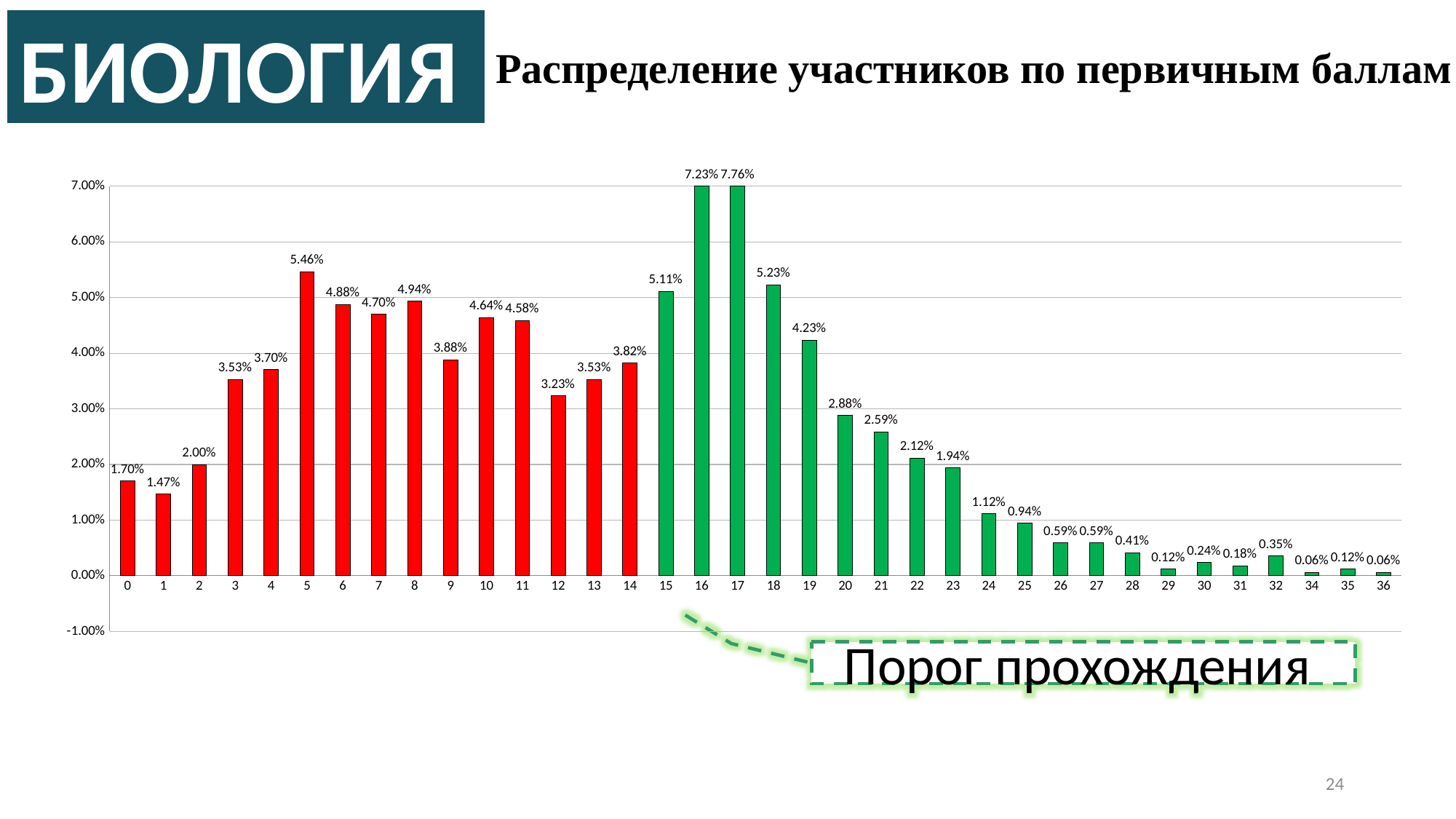
Which primary score has the highest share of participants? 17 What is the difference between the values for scores 17 and 16? 0.53% What percentage of participants scored 17 primary points? 7.76% How many primary score categories are shown on the x axis? 36 What is the difference between the values for scores 5 and 4? 1.76% What is the value shown for a primary score of 5? 5.46% What percentage is shown for a primary score of 28? 0.41% Which is larger, the value for score 5 or the value for score 15? score 5 What kind of chart is shown on the slide? bar chart Is the value for score 10 greater or less than 4.00%? greater What colour are the bars for scores 15 and above? green Do the values rise or fall from score 17 to score 28? fall